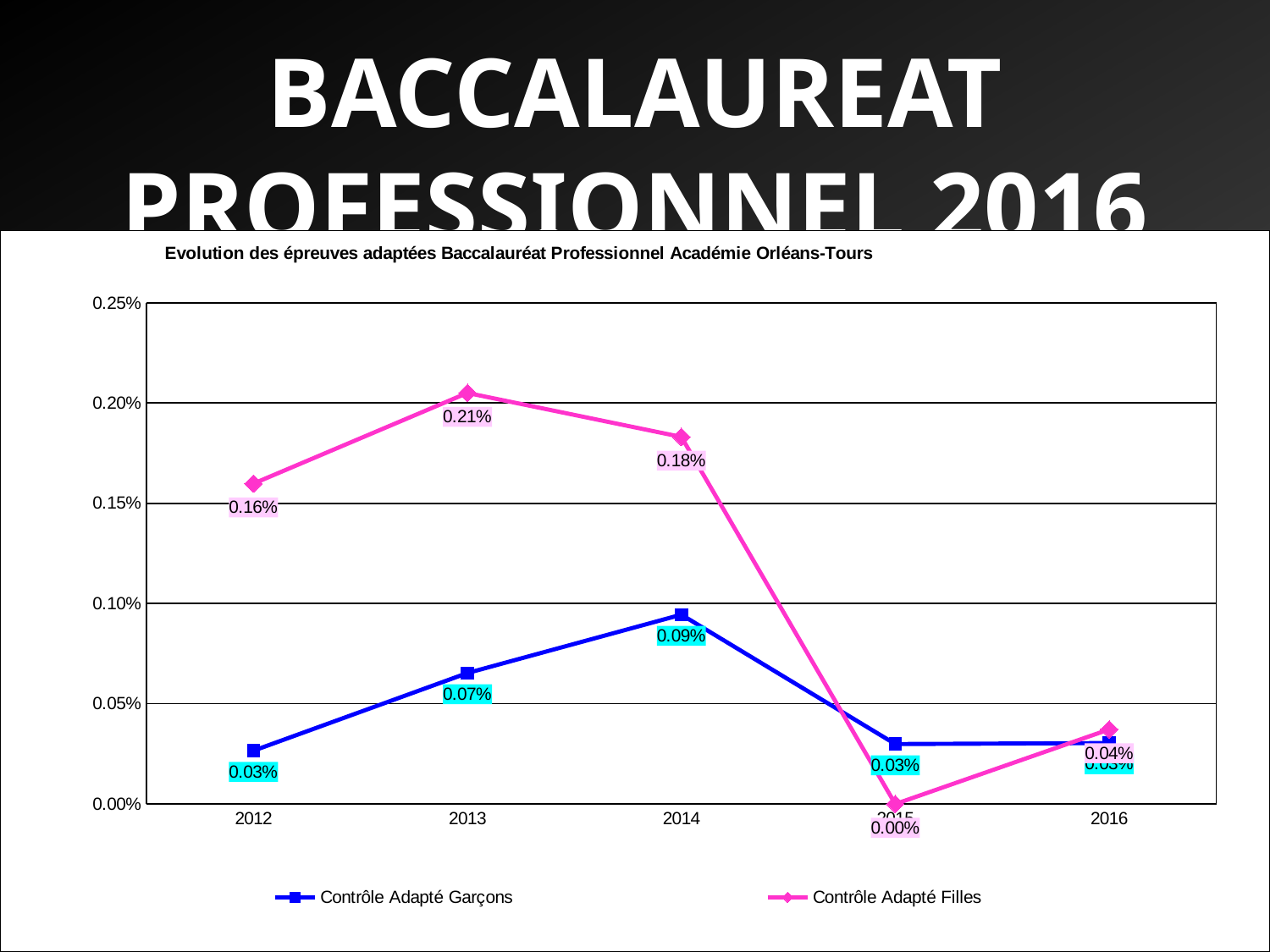
What is the value for Contrôle Adapté Filles in 2015? 0.00% How many series does the legend list? 2 Is the value for Contrôle Adapté Filles in 2012 greater or less than 0.10%? greater What is the value for Contrôle Adapté Filles in 2013? 0.21% How many years are shown on the x axis? 5 In which year is the Contrôle Adapté Filles value lowest? 2015 Does the Contrôle Adapté Garçons value rise or fall from 2012 to 2014? rise In which year is the Contrôle Adapté Filles value highest? 2013 What is the difference between the Contrôle Adapté Filles values in 2013 and 2014? 0.03% What kind of chart is shown on the slide? line chart In 2012, which series has the larger value, Contrôle Adapté Garçons or Contrôle Adapté Filles? Contrôle Adapté Filles What is the value for Contrôle Adapté Garçons in 2014? 0.09%